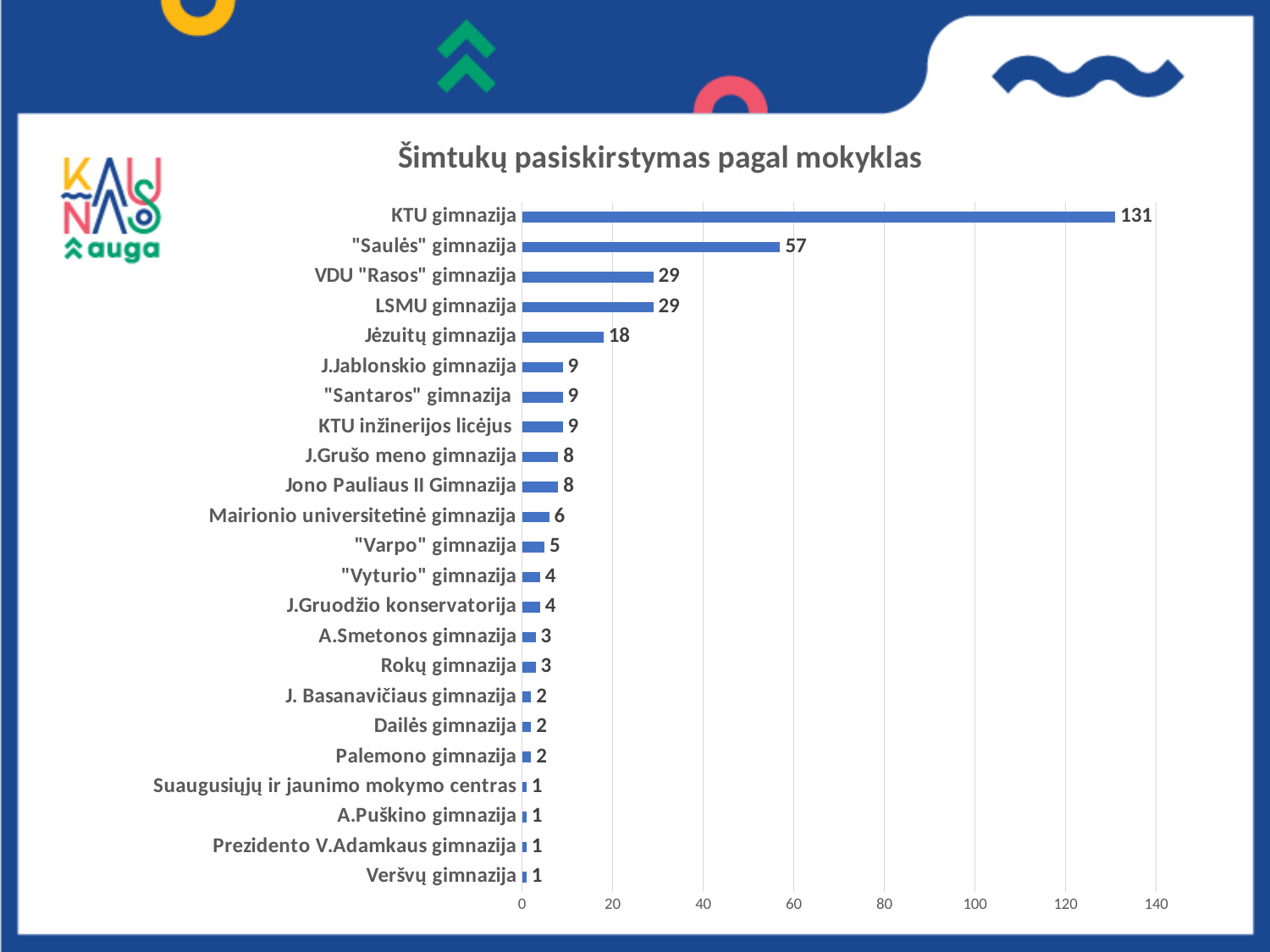
Which is larger, the value for Jėzuitų gimnazija or the value for J.Jablonskio gimnazija? Jėzuitų gimnazija What is the difference between the values for "Saulės" gimnazija and LSMU gimnazija? 28 What kind of chart is shown on the slide? bar chart What is the value for "Saulės" gimnazija? 57 What is the value for Mairionio universitetinė gimnazija? 6 What is the value for KTU gimnazija? 131 What is the value for Jėzuitų gimnazija? 18 How many schools are shown in the chart? 23 Is the value for KTU gimnazija greater or less than 120? greater Which school has the highest value? KTU gimnazija What is the difference between the values for KTU gimnazija and "Saulės" gimnazija? 74 What is the title of the chart? Šimtukų pasiskirstymas pagal mokyklas